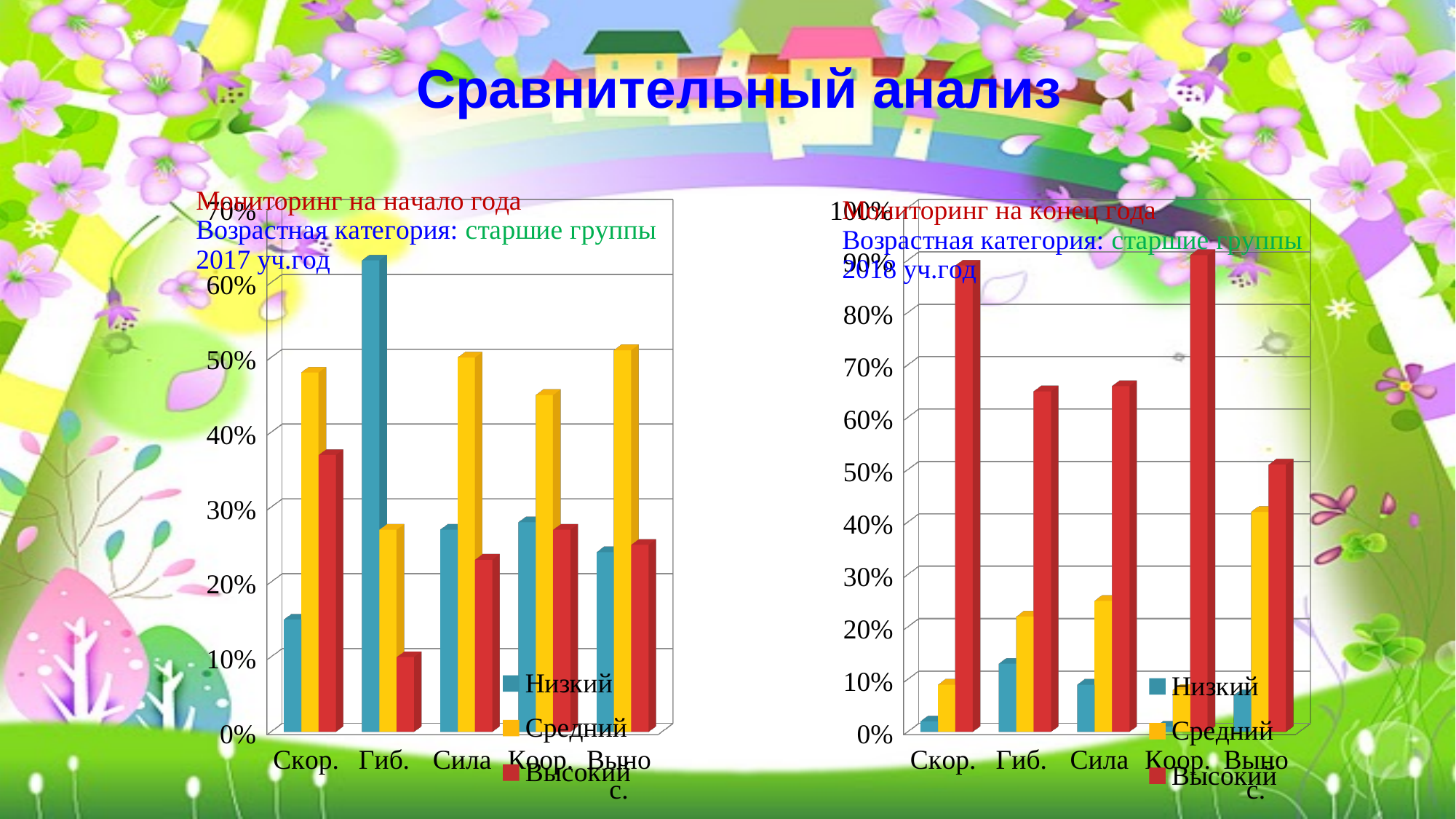
What kind of chart is the left chart (Мониторинг на начало года)? bar chart On the right chart (Мониторинг на конец года), is the Высокий value for Скор. greater or less than 80%? greater How many series does the legend of the right chart (Мониторинг на конец года) list? 3 On the left chart (Мониторинг на начало года), which category has the highest value for the Низкий series? Гиб. On the left chart (Мониторинг на начало года), is the Высокий value for Гиб. greater or less than 20%? less On the right chart (Мониторинг на конец года), which is larger for Сила: the Средний value or the Высокий value? Высокий On the right chart (Мониторинг на конец года), which category has the lowest value for the Высокий series? Вынос. How many categories are shown on the x axis of the left chart (Мониторинг на начало года)? 5 On the left chart (Мониторинг на начало года), which is larger for Гиб.: the Низкий value or the Высокий value? Низкий On the left chart (Мониторинг на начало года), is the Низкий value for Гиб. greater or less than 60%? greater